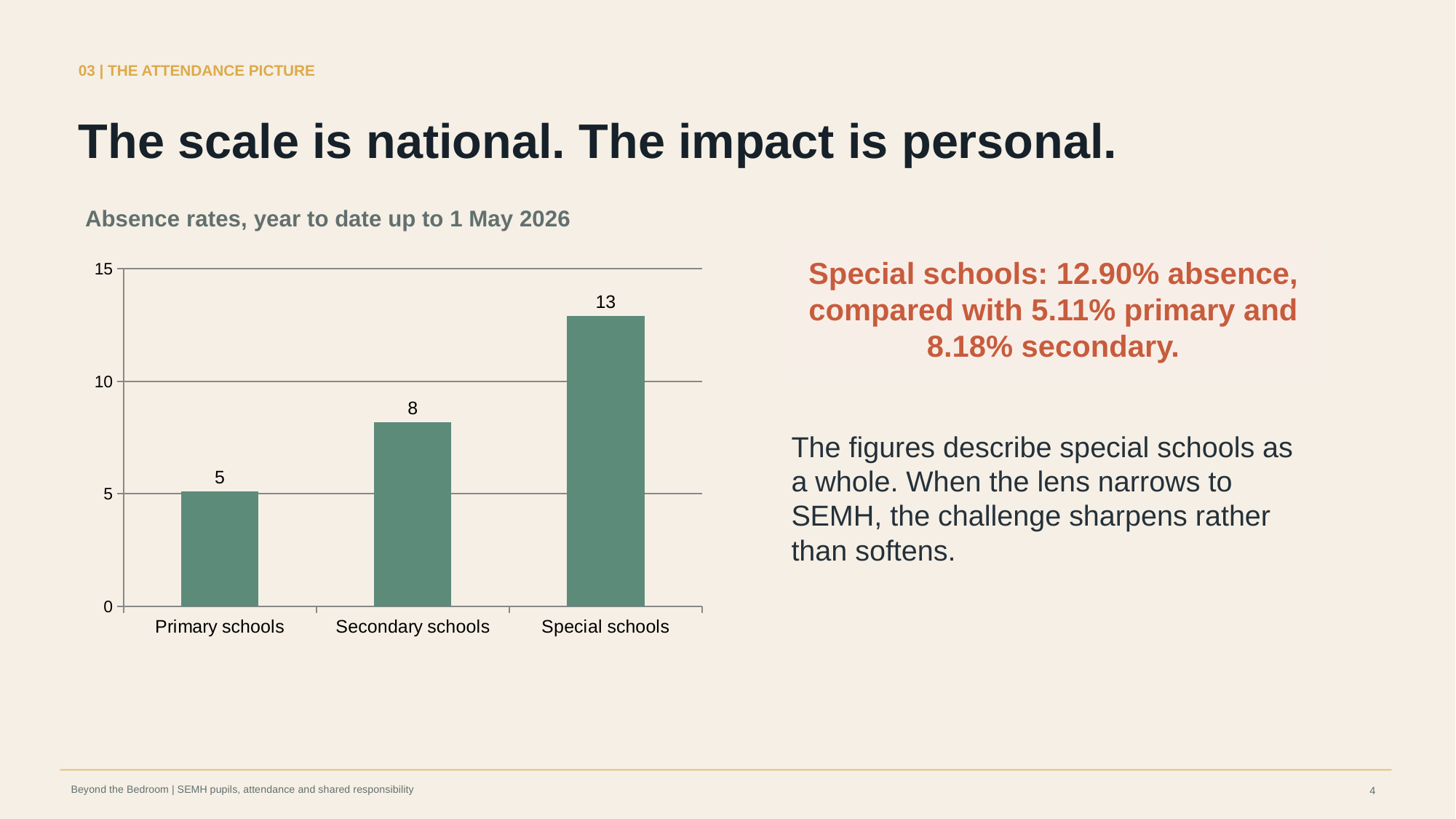
Which is larger, the value for Secondary schools or the value for Primary schools? Secondary schools What is the data label shown for Special schools in the chart? 13 How many categories are shown on the x axis of the chart? 3 What is the data label shown for Secondary schools in the chart? 8 Using the data labels, what is the difference between the Special schools and Primary schools values? 8 Which school type has the highest absence rate in the chart? Special schools Which school type has the lowest absence rate in the chart? Primary schools Using the data labels, what is the difference between the Secondary schools and Primary schools values? 3 What kind of chart is shown on the slide? Bar chart What is the data label shown for Primary schools in the chart? 5 Is the value for Special schools greater or less than 10? greater What is the title of the chart? Absence rates, year to date up to 1 May 2026